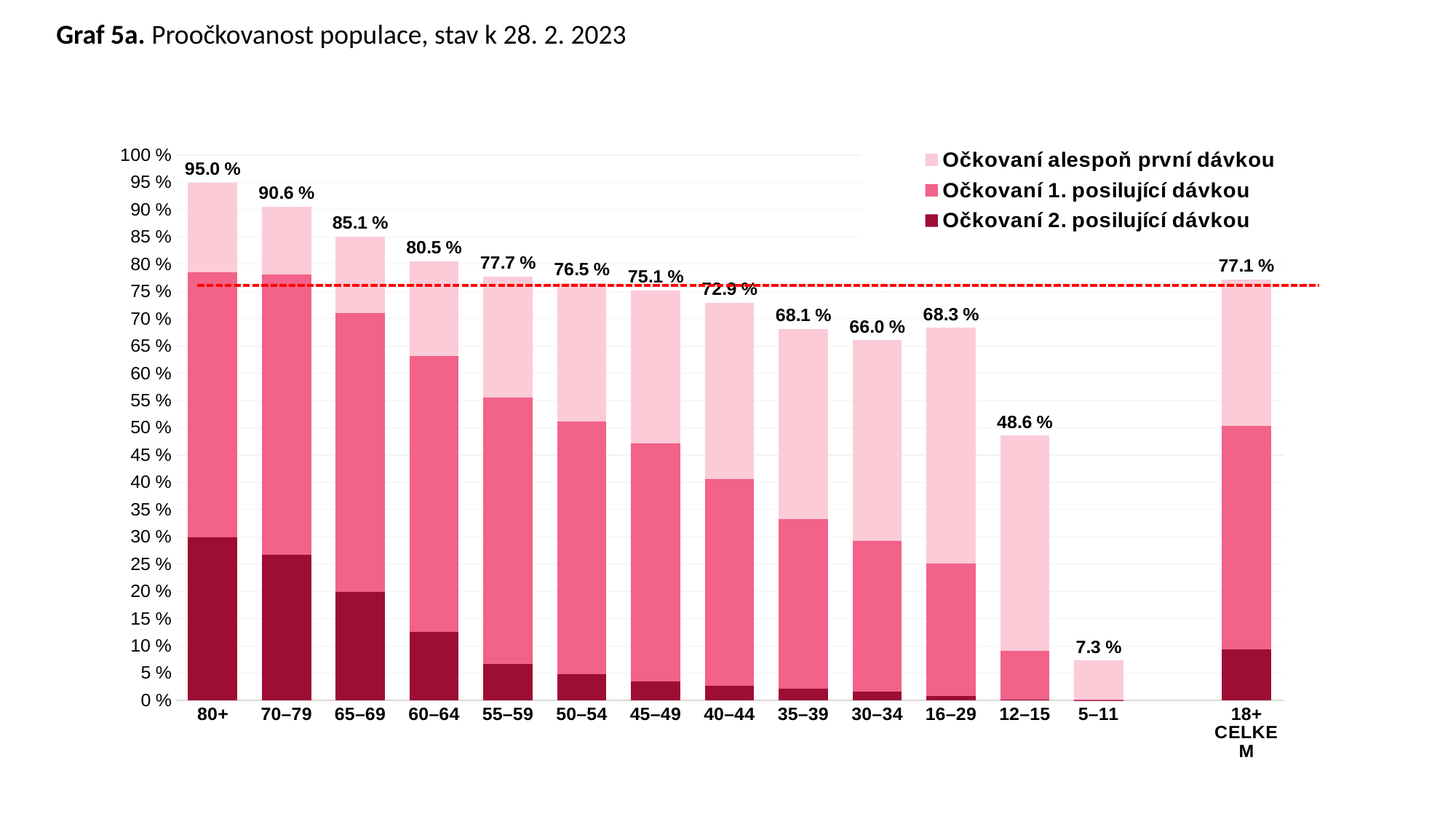
What is the difference between the labelled values for 70–79 and 65–69? 5.5 % Which has the larger labelled value, 16–29 or 30–34? 16–29 What is the labelled value for the 80+ age group? 95.0 % What is the labelled value for the 18+ CELKEM bar? 77.1 % Is the value for Očkovaní 1. posilující dávkou in the 12–15 age group greater or less than 10 %? less What is the labelled value for the 12–15 age group? 48.6 % How many series does the legend list? 3 How many age-group categories are shown on the x axis? 14 Which age group has the lowest labelled value? 5–11 What kind of chart is this? bar chart What is the difference between the labelled values for 80+ and 5–11? 87.7 % Which age group has the highest labelled value? 80+